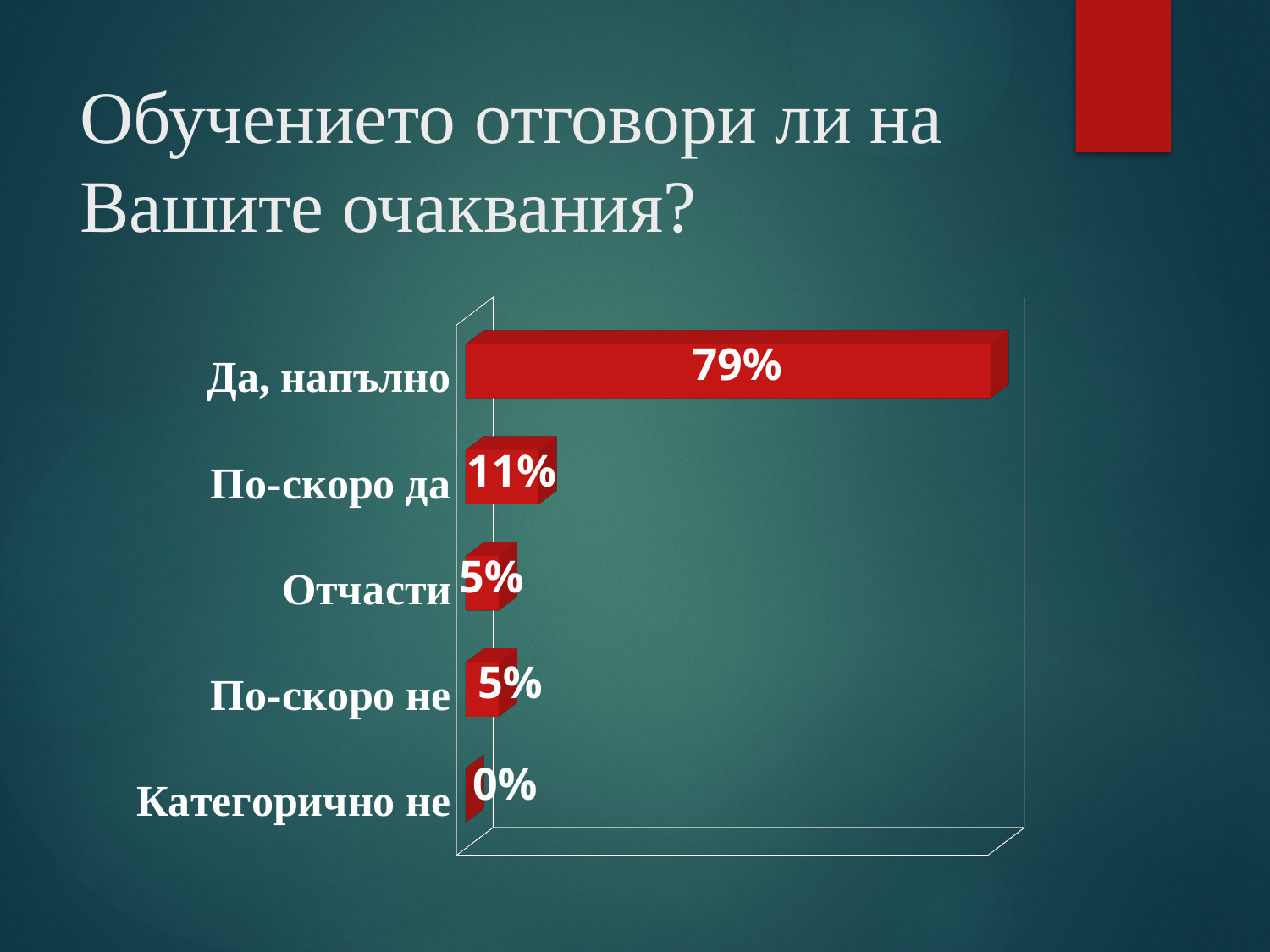
Which category has the lowest value? Категорично не What kind of chart is shown on the slide? Bar chart How many categories are shown in the chart? 5 What is the value for "Категорично не"? 0% What is the title of the slide containing the chart? Обучението отговори ли на Вашите очаквания? What is the value for "Да, напълно"? 79% What colour are the bars in the chart? Red Which is larger, the value for "По-скоро да" or the value for "По-скоро не"? По-скоро да Which category has the highest value? Да, напълно What is the value for "Отчасти"? 5% What is the difference between the values for "Да, напълно" and "По-скоро да"? 68% What is the value for "По-скоро да"? 11%